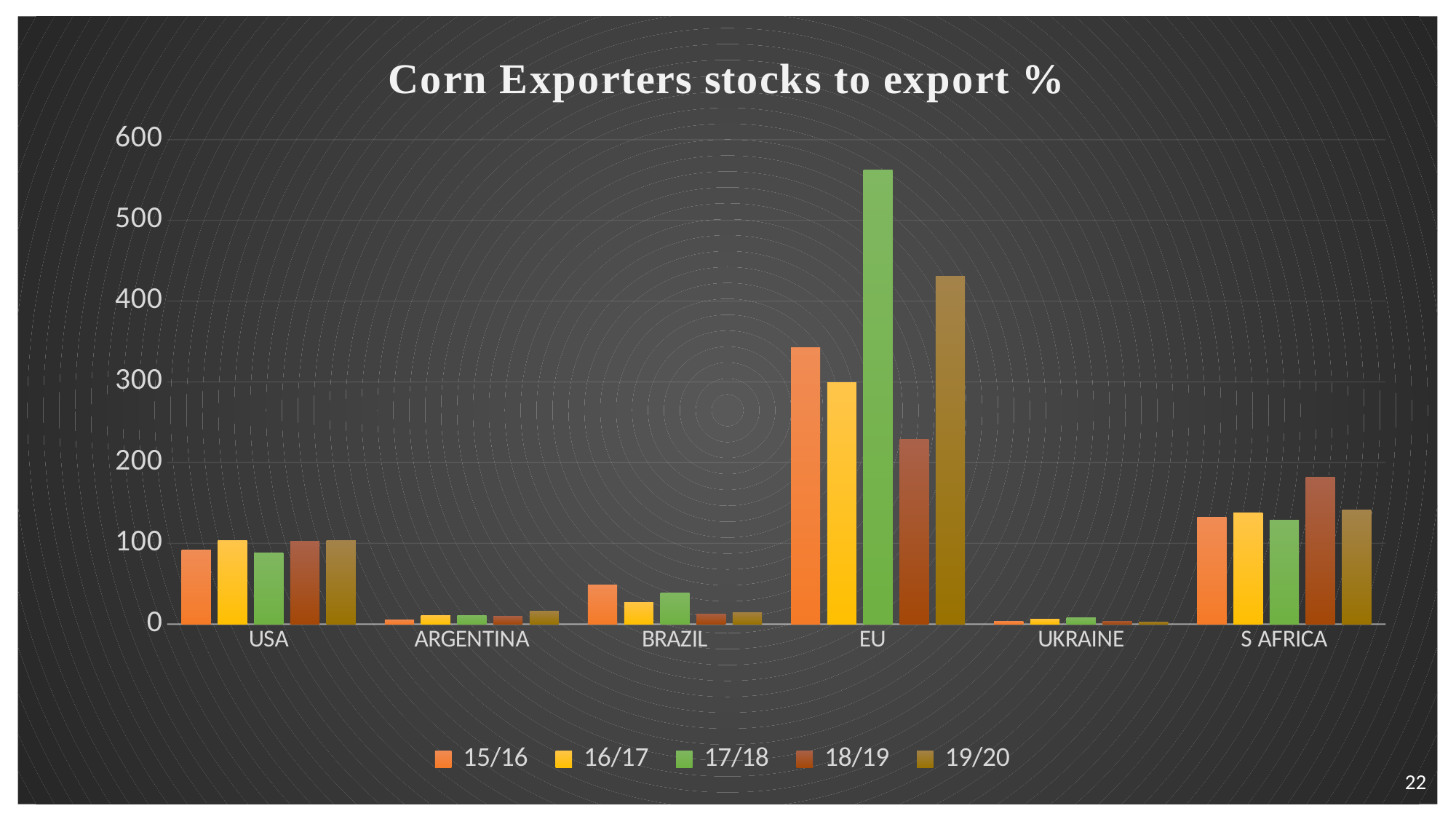
Which series has the highest value for EU? 17/18 Is the 17/18 value for EU greater or less than 500? greater Which country has the highest bar in the chart? EU What kind of chart is shown on the slide? bar chart Which is larger for S Africa, the 18/19 value or the 19/20 value? 18/19 How many series does the legend list? 5 Which is larger for Brazil, the 15/16 value or the 18/19 value? 15/16 What is the title of the chart? Corn Exporters stocks to export % How many countries are shown on the x axis? 6 Is the 15/16 value for USA greater or less than 100? less Which series is shown in green in the legend? 17/18 Is the 19/20 value for EU greater or less than 400? greater